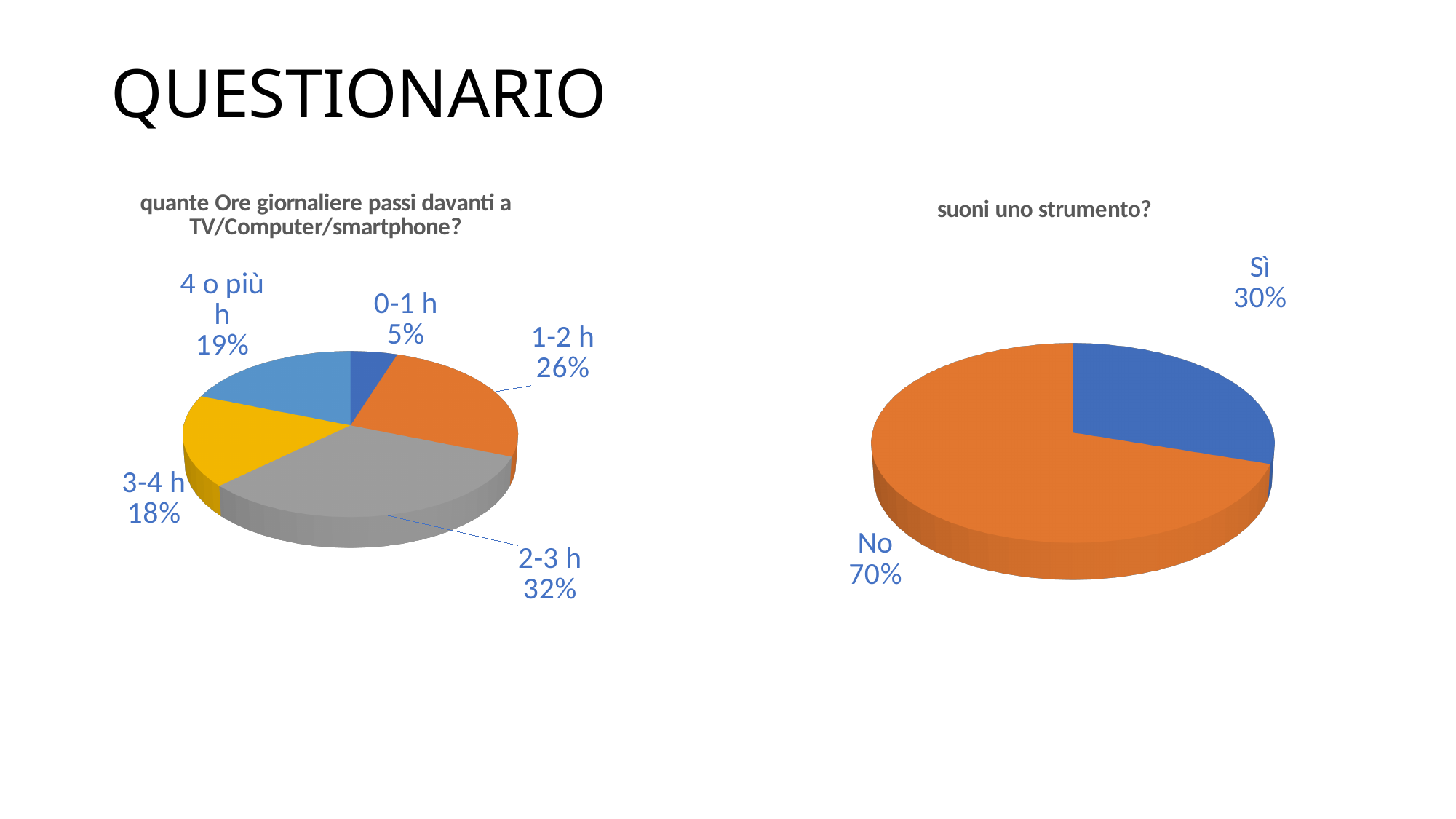
In the right chart (suoni uno strumento?), what is the difference between the No share and the Sì share? 40% In the left chart (quante Ore giornaliere passi davanti a TV/Computer/smartphone?), which is larger: the share for 4 o più h or the share for 3-4 h? 4 o più h What is the title of the right chart? suoni uno strumento? How many slices does the left chart (quante Ore giornaliere passi davanti a TV/Computer/smartphone?) have? 5 In the right chart (suoni uno strumento?), what share is labelled for Sì? 30% In the left chart (quante Ore giornaliere passi davanti a TV/Computer/smartphone?), what share is labelled for 2-3 h? 32% In the left chart (quante Ore giornaliere passi davanti a TV/Computer/smartphone?), which category has the smallest slice? 0-1 h In the right chart (suoni uno strumento?), what share is labelled for No? 70% In the left chart (quante Ore giornaliere passi davanti a TV/Computer/smartphone?), which category has the largest slice? 2-3 h In the left chart (quante Ore giornaliere passi davanti a TV/Computer/smartphone?), what is the difference between the 2-3 h share and the 1-2 h share? 6% In the left chart (quante Ore giornaliere passi davanti a TV/Computer/smartphone?), what share is labelled for 0-1 h? 5% What kind of chart is the left chart (quante Ore giornaliere passi davanti a TV/Computer/smartphone?)? Pie chart